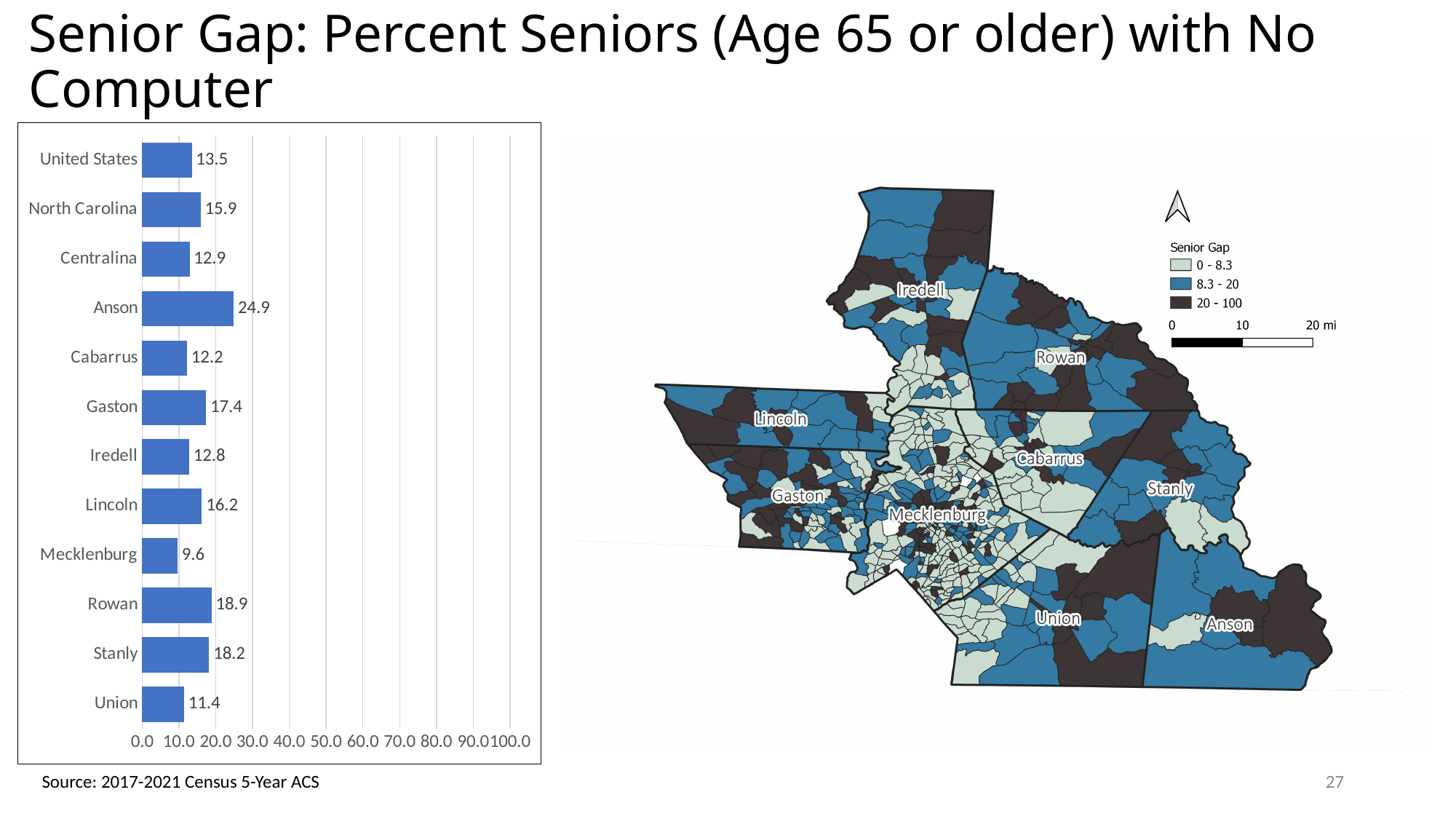
What is the difference between the values for North Carolina and United States in the bar chart? 2.4 Which category has the highest value in the bar chart? Anson Is the value for Gaston in the bar chart greater or less than 20.0? less Which category has the lowest value in the bar chart? Mecklenburg What is the difference between the values for Anson and Mecklenburg in the bar chart? 15.3 How many categories are shown in the bar chart? 12 What is the value for Mecklenburg in the bar chart? 9.6 What is the value for Rowan in the bar chart? 18.9 What kind of chart is shown on the left of the slide? Bar chart Which has a larger value in the bar chart, Rowan or Stanly? Rowan What is the value for Anson in the bar chart? 24.9 What is the value for North Carolina in the bar chart? 15.9